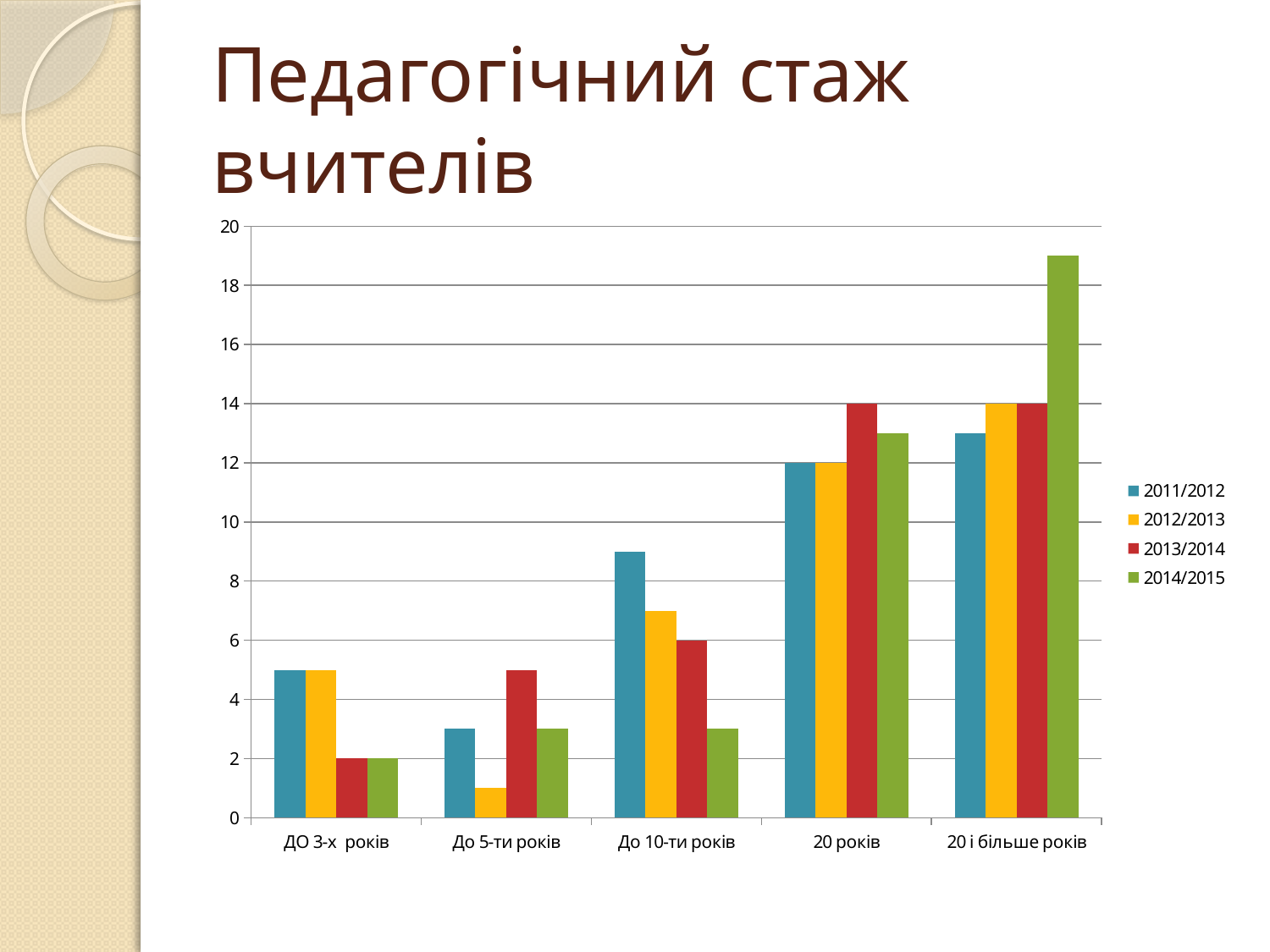
In the category "До 10-ти років", which is larger: the value for 2011/2012 or for 2014/2015? 2011/2012 How many series does the legend list? 4 What is the difference between the 2013/2014 and 2011/2012 values in the category "20 років"? 2 Is the value for 2012/2013 in the category "До 5-ти років" greater or less than 2? less What kind of chart is shown on the slide? bar chart What is the value for 2013/2014 in the category "20 років"? 14 Do the values for the 2014/2015 series rise or fall from left to right across the categories? rise Is the value for 2014/2015 in the category "20 і більше років" greater or less than 18? greater What is the value for 2011/2012 in the category "20 років"? 12 What is the value for 2014/2015 in the category "ДО 3-х років"? 2 Which series has the highest bar in the category "20 і більше років"? 2014/2015 How many categories are shown on the x axis? 5